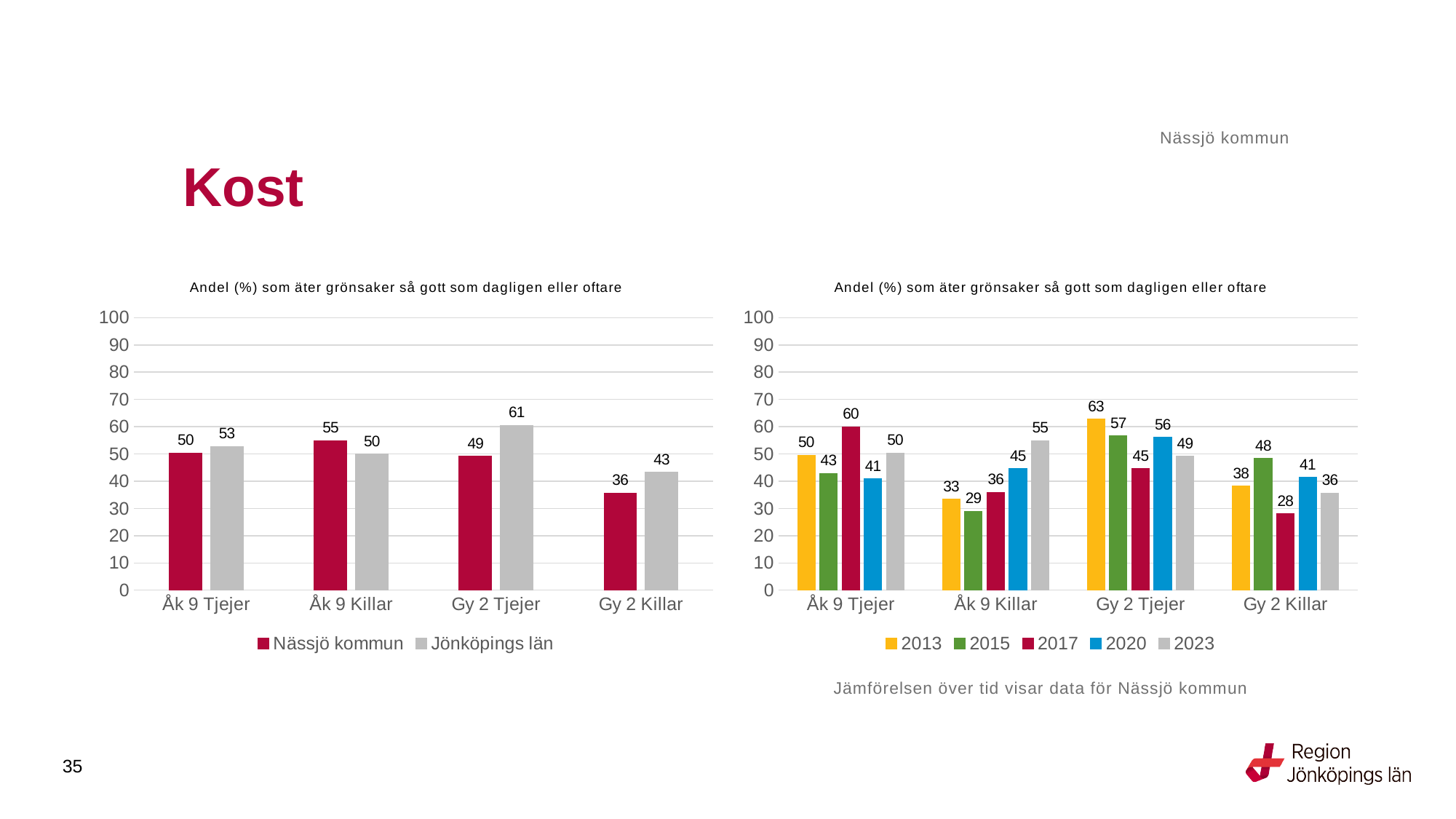
In the right chart, what is the value for 2023 for Åk 9 Killar? 55 In the left chart, which category has the lowest value for Nässjö kommun? Gy 2 Killar How many series does the legend of the right chart list? 5 In the right chart, which year has the lowest value for Gy 2 Killar? 2017 In the left chart, what is the difference between Jönköpings län and Nässjö kommun for Gy 2 Tjejer? 12 How many series does the legend of the left chart list? 2 In the left chart, which is larger for Åk 9 Killar: Nässjö kommun or Jönköpings län? Nässjö kommun What kind of chart is the right chart? Bar chart In the right chart, what is the value for 2017 for Åk 9 Tjejer? 60 In the left chart, what is the value for Nässjö kommun for Åk 9 Killar? 55 In the right chart, which year has the highest value for Gy 2 Tjejer? 2013 In the left chart, what is the value for Jönköpings län for Gy 2 Tjejer? 61